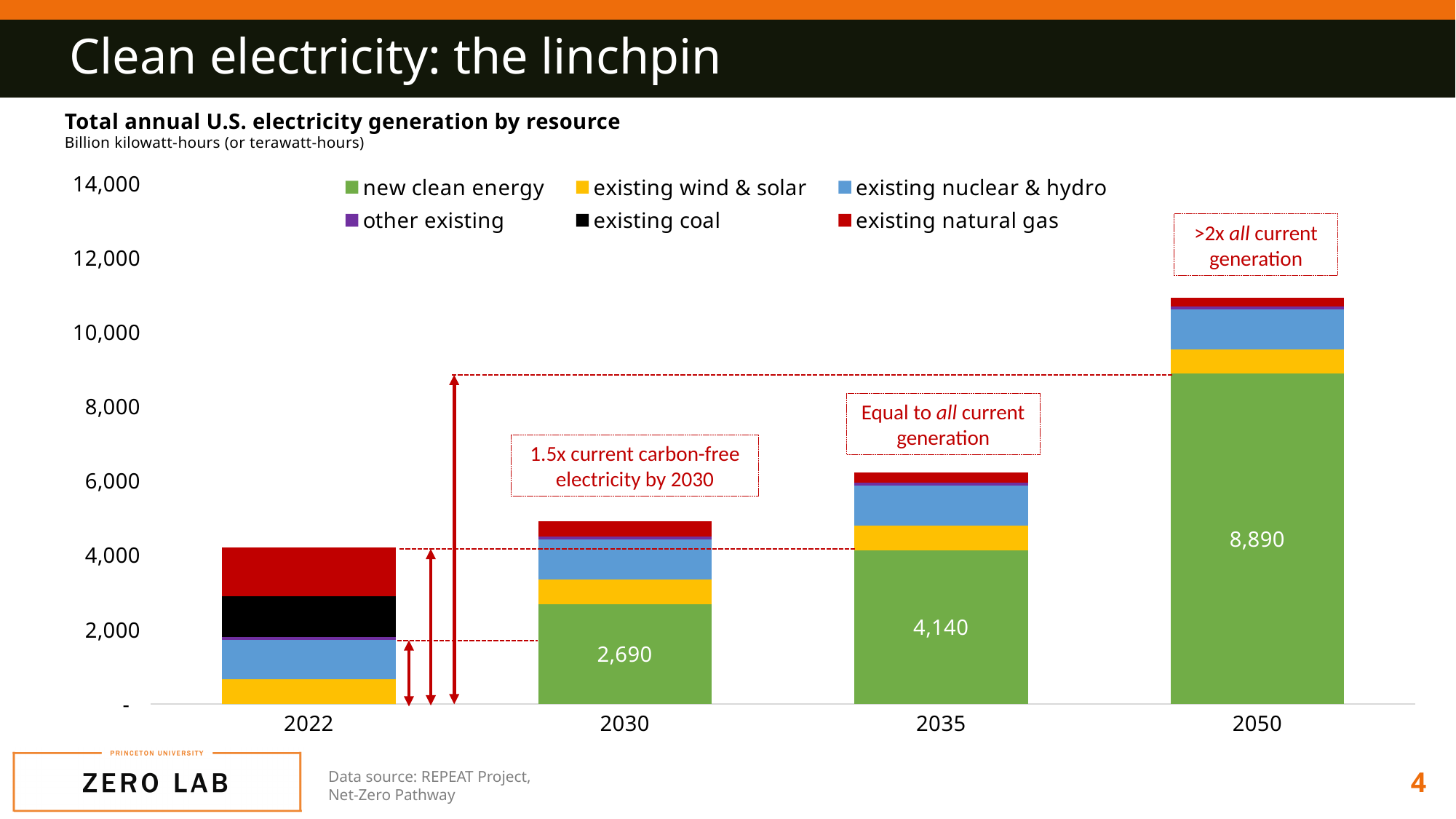
What is the title of the chart? Total annual U.S. electricity generation by resource What is the difference between new clean energy in 2035 and in 2030? 1,450 What is the value of new clean energy in 2030? 2,690 Is the total generation for 2050 greater or less than 10,000? greater What is the value of new clean energy in 2035? 4,140 What kind of chart is shown on the slide? Stacked bar chart What is the value of new clean energy in 2050? 8,890 What is the difference between new clean energy in 2050 and in 2035? 4,750 In which year is new clean energy generation highest? 2050 How many years are shown on the x axis? 4 How many series does the legend list? 6 Is the total generation for 2022 greater or less than 6,000? less